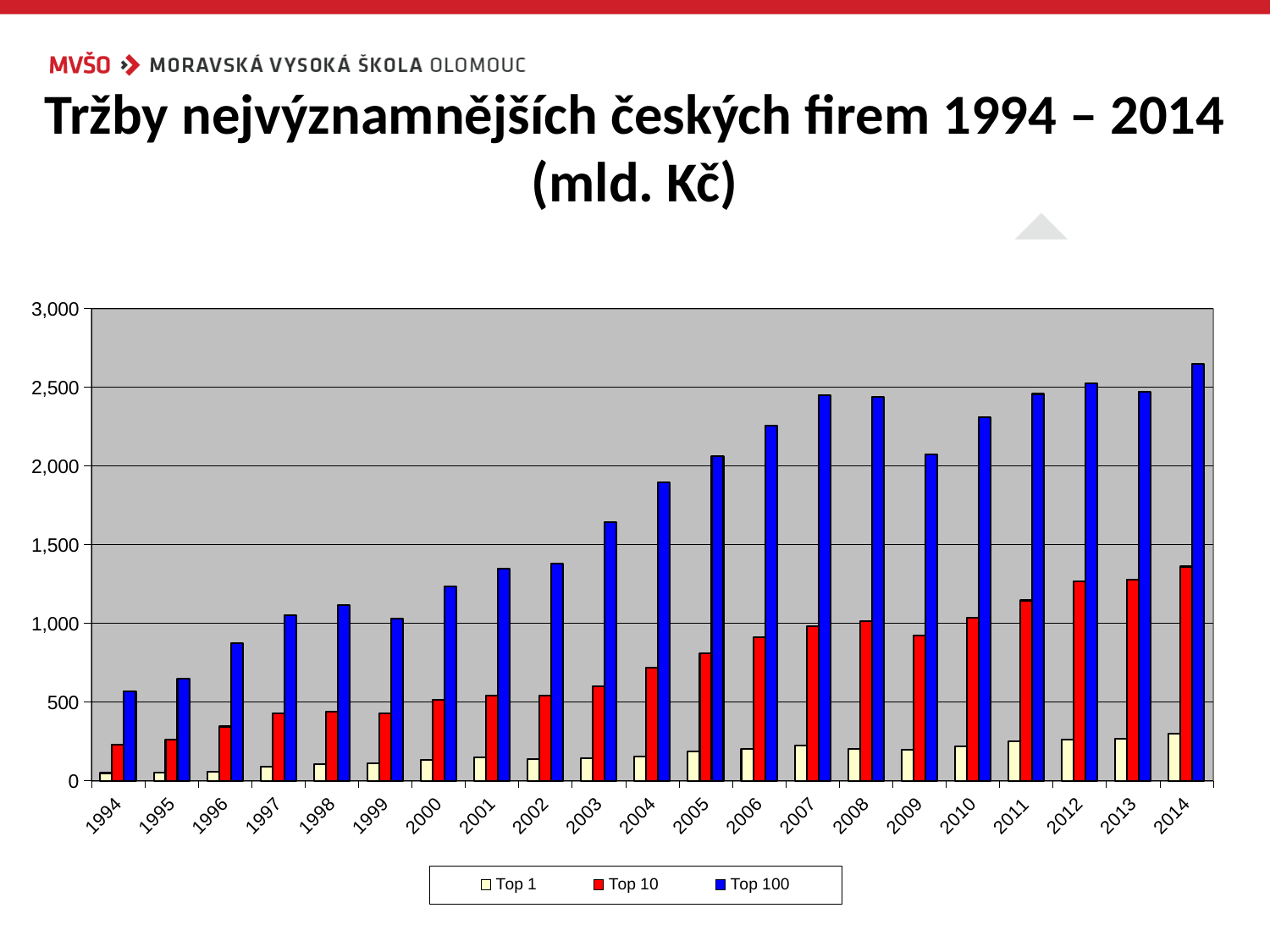
Is the value for Top 1 in 2014 greater or less than 500? less Which year has the lowest value for Top 100? 1994 Is the value for Top 100 in 2003 greater or less than 1,500? greater Does the Top 100 series generally rise or fall from 1994 to 2014? rise How many years are shown on the x axis? 21 Is the value for Top 100 in 2014 greater or less than 2,500? greater Which is larger, the Top 100 value for 2007 or for 2009? 2007 How many series does the legend list? 3 What kind of chart is shown on the slide? bar chart Which year has the highest value for Top 100? 2014 Which year has the highest value for Top 10? 2014